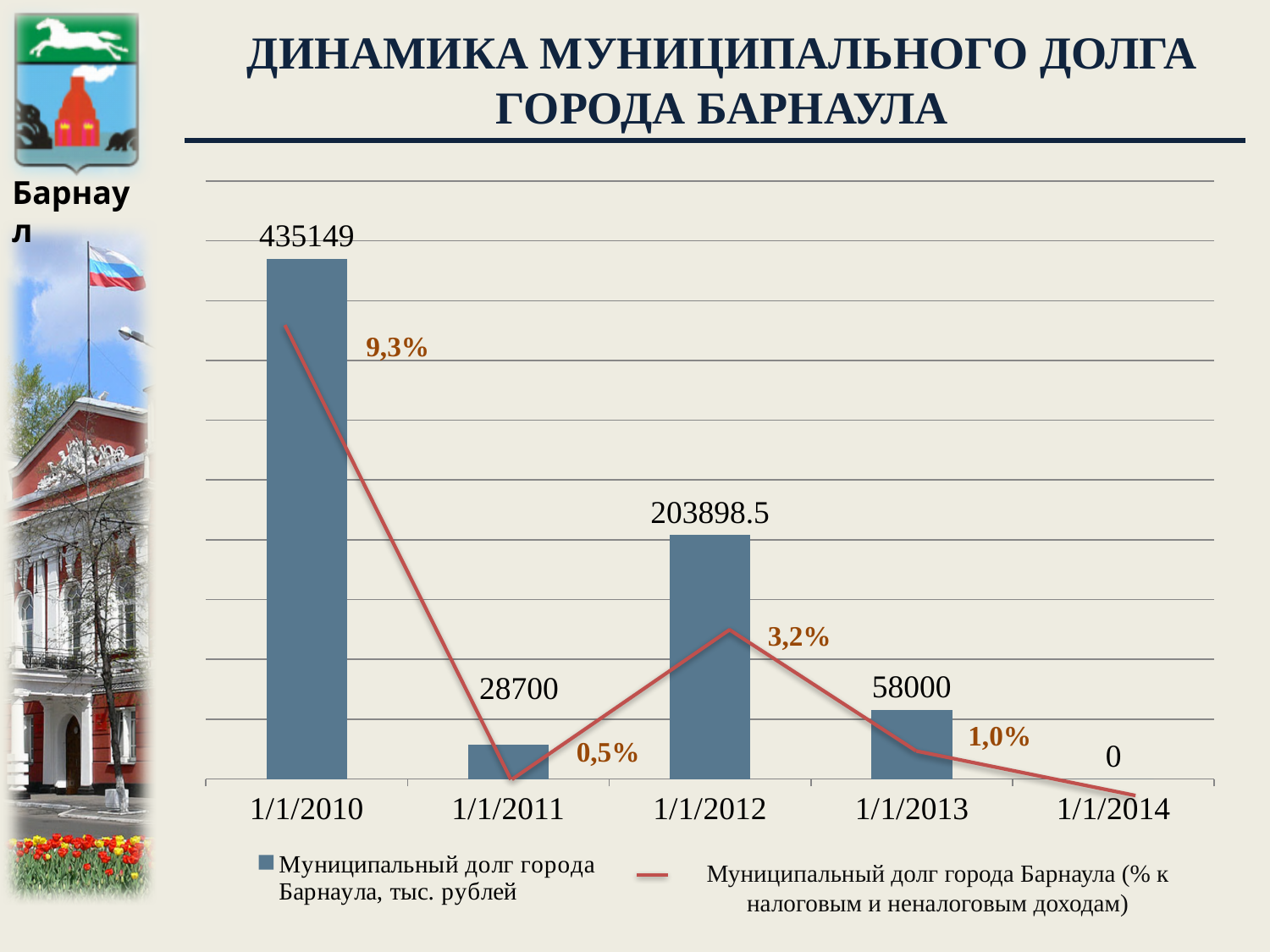
What is the difference in municipal debt (thousand rubles) between 1/1/2013 and 1/1/2011? 29300 What kind of chart is shown on the slide? A bar chart combined with a line chart What is the municipal debt as a percentage of tax and non-tax revenues on 1/1/2012? 3,2% How many dates are shown on the x axis of the chart? 5 Which date has a larger municipal debt in thousand rubles, 1/1/2011 or 1/1/2013? 1/1/2013 On which date is the municipal debt in thousand rubles the highest? 1/1/2010 What is the municipal debt of Barnaul in thousand rubles on 1/1/2013? 58000 On which date is the municipal debt in thousand rubles the lowest? 1/1/2014 What is the municipal debt as a percentage of tax and non-tax revenues on 1/1/2010? 9,3% How many series does the chart legend list? 2 What is the municipal debt of Barnaul in thousand rubles on 1/1/2010? 435149 What is the municipal debt of Barnaul in thousand rubles on 1/1/2012? 203898.5